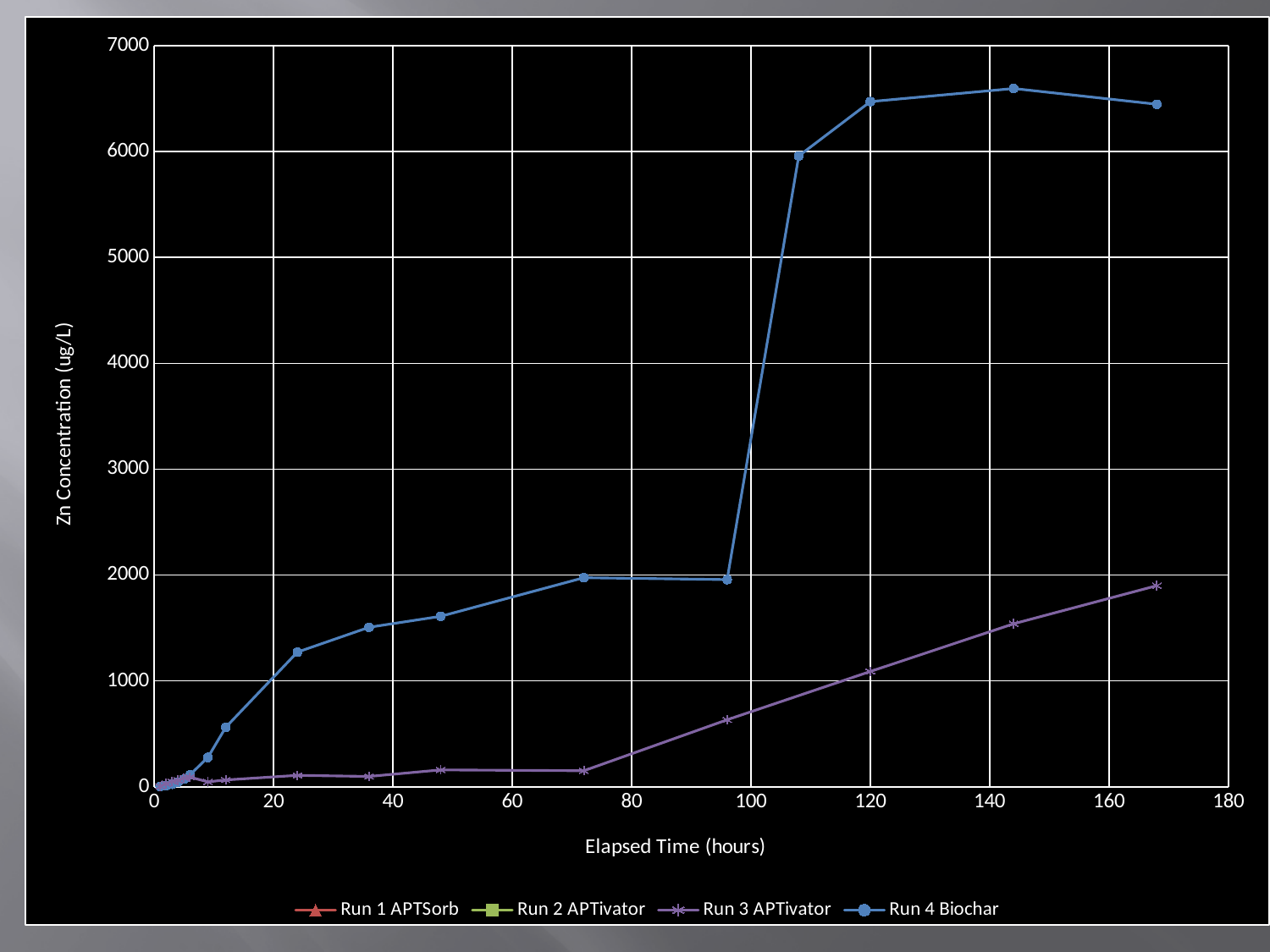
What is the title of the vertical axis? Zn Concentration (ug/L) Which series reaches the highest Zn concentration on the chart? Run 4 Biochar Is the value for Run 4 Biochar at 144 hours greater or less than 6000? greater Is the value for Run 3 APTivator at 168 hours greater or less than 2000? less Is the value for Run 4 Biochar at 120 hours greater or less than 6000? greater How many series does the legend list? 4 Does the Run 3 APTivator series generally rise or fall as elapsed time increases? rise At 168 hours, which series has the higher Zn concentration, Run 3 APTivator or Run 4 Biochar? Run 4 Biochar What kind of chart is shown on the slide? line chart